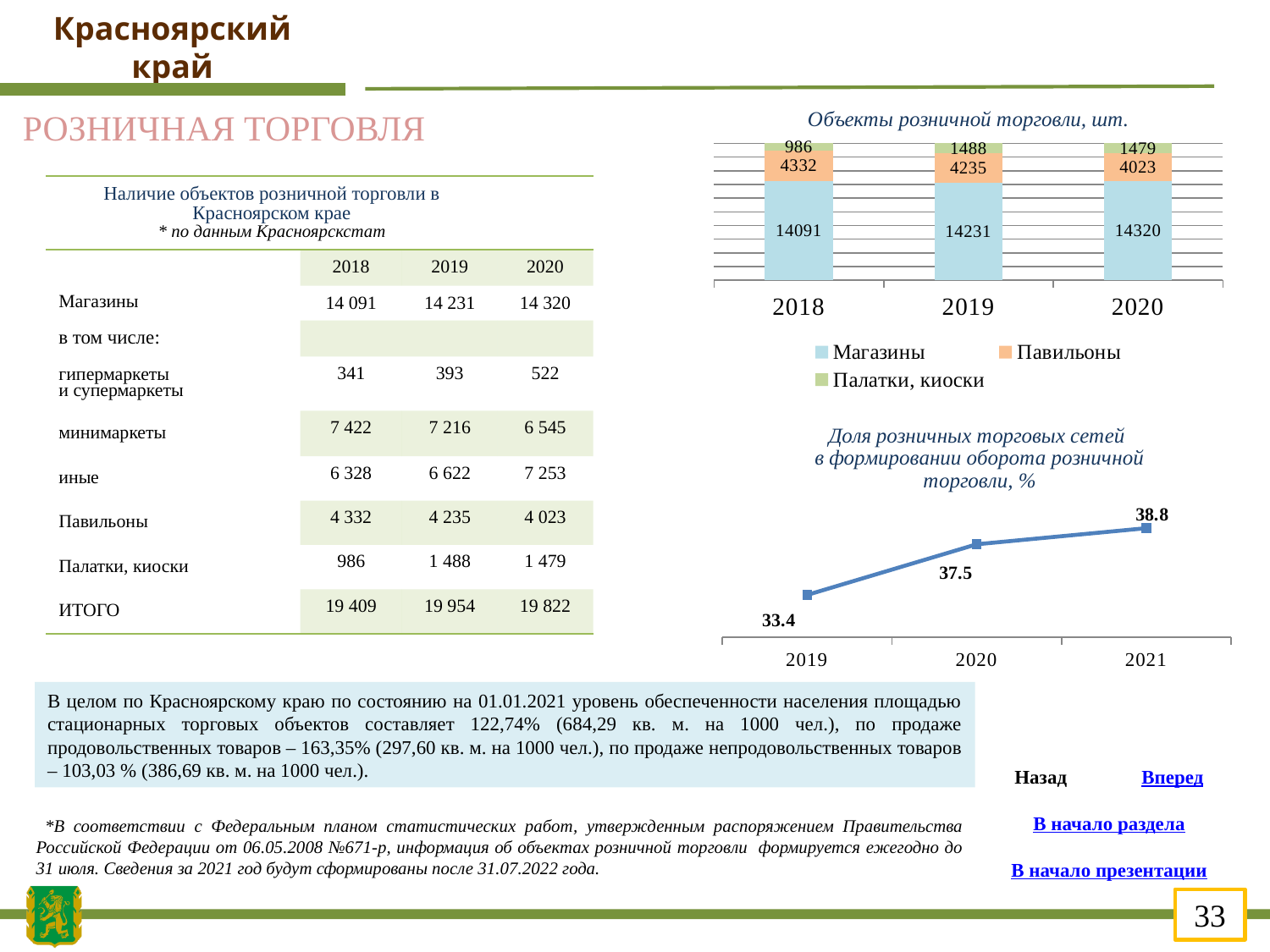
In the chart 'Объекты розничной торговли, шт.', what is the value for Павильоны in 2018? 4332 In the chart 'Объекты розничной торговли, шт.', what kind of chart is shown? Stacked bar chart In the chart 'Объекты розничной торговли, шт.', how many series does the legend list? 3 In the chart 'Объекты розничной торговли, шт.', what is the value for Магазины in 2020? 14320 In the line chart 'Доля розничных торговых сетей в формировании оборота розничной торговли, %', what is the difference between the 2021 and 2019 values? 5.4 In the chart 'Объекты розничной торговли, шт.', what is the difference between the Павильоны values for 2018 and 2020? 309 In the line chart 'Доля розничных торговых сетей в формировании оборота розничной торговли, %', which year has the lowest value? 2019 In the line chart 'Доля розничных торговых сетей в формировании оборота розничной торговли, %', do the values rise or fall from 2019 to 2021? Rise In the chart 'Объекты розничной торговли, шт.', what is the value for Палатки, киоски in 2019? 1488 In the chart 'Объекты розничной торговли, шт.', what is the total of the stacked bar for 2019? 19954 In the line chart 'Доля розничных торговых сетей в формировании оборота розничной торговли, %', what is the value for 2020? 37.5 In the chart 'Объекты розничной торговли, шт.', which year has the highest value for Магазины? 2020